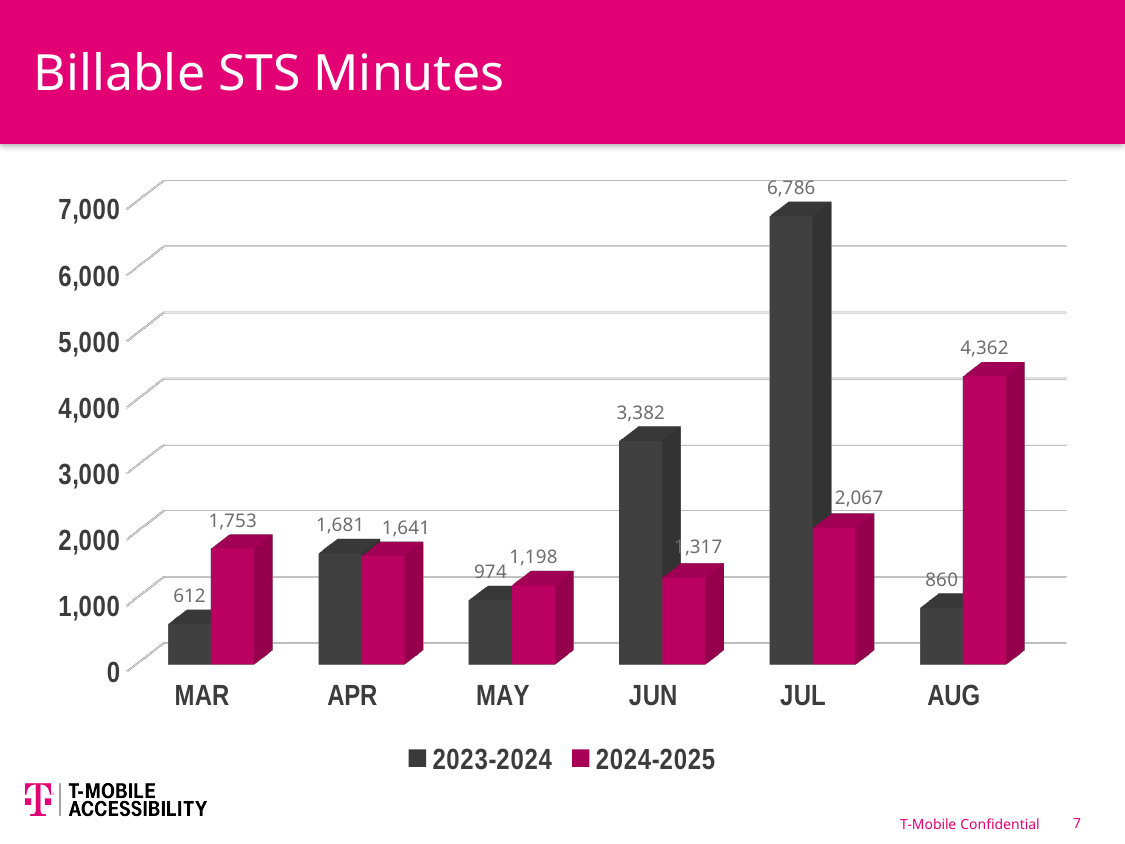
What is the title of the slide? Billable STS Minutes Which month has the lowest value for the 2024-2025 series? MAY How many months are shown on the x axis? 6 What is the value for 2024-2025 in MAY? 1,198 Which month has the highest value for the 2023-2024 series? JUL What is the value for 2023-2024 in MAR? 612 What is the difference between the 2023-2024 and 2024-2025 values in JUL? 4,719 What kind of chart is shown on the slide? Bar chart How many series does the legend list? 2 Which is larger in JUN, the 2023-2024 value or the 2024-2025 value? 2023-2024 What is the value for 2024-2025 in AUG? 4,362 What is the value for 2023-2024 in JUL? 6,786